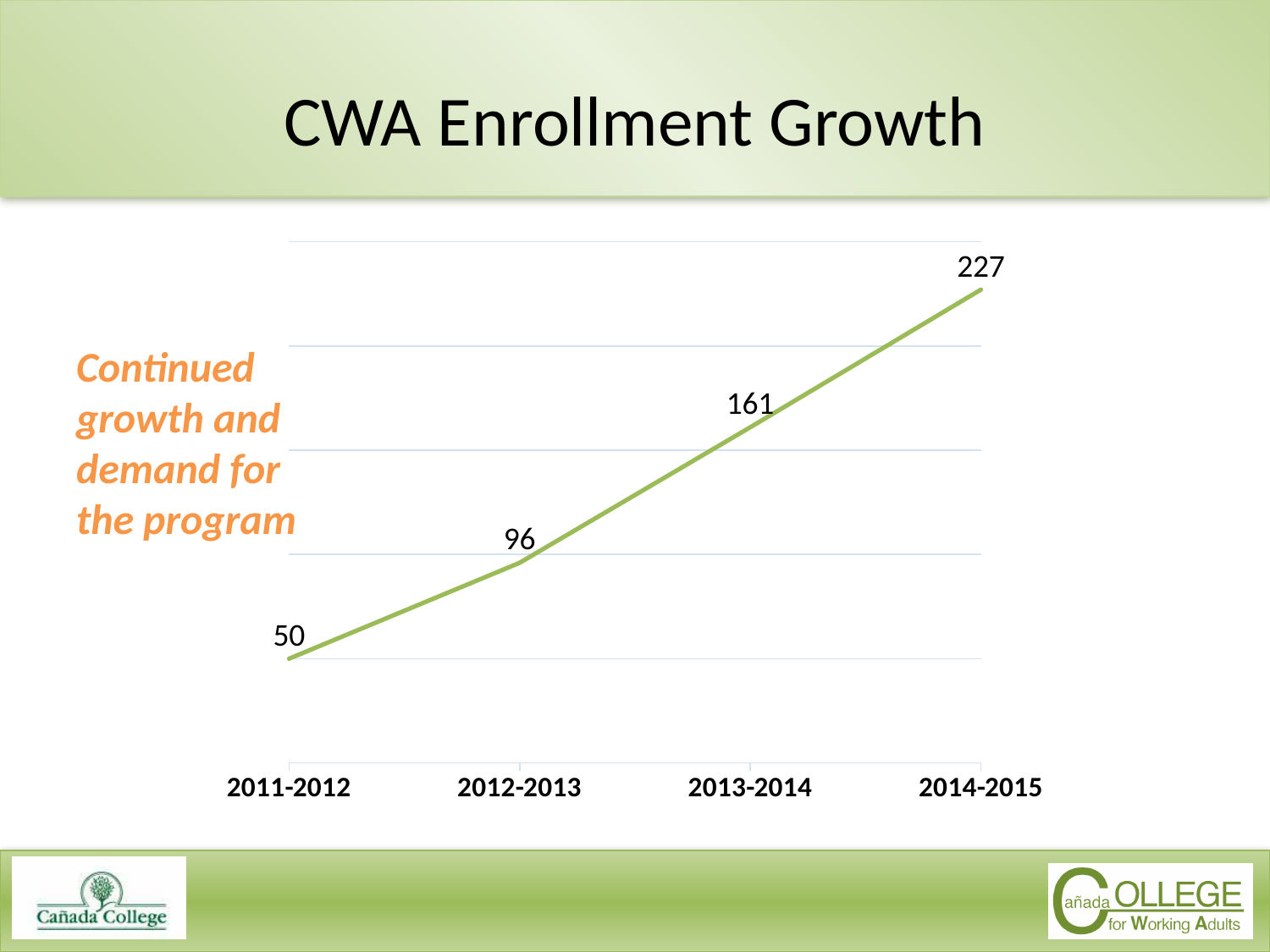
What is the difference in enrollment between 2014-2015 and 2011-2012? 177 What is the enrollment value for 2014-2015? 227 Which year has the lowest enrollment? 2011-2012 Which is larger, the enrollment for 2012-2013 or for 2013-2014? 2013-2014 What is the enrollment value for 2011-2012? 50 What kind of chart is shown on the slide? line chart What is the enrollment value for 2013-2014? 161 What is the enrollment value for 2012-2013? 96 Do the enrollment values rise or fall from 2011-2012 to 2014-2015? rise What is the difference in enrollment between 2013-2014 and 2012-2013? 65 How many years are plotted on the chart? 4 Which year has the highest enrollment? 2014-2015